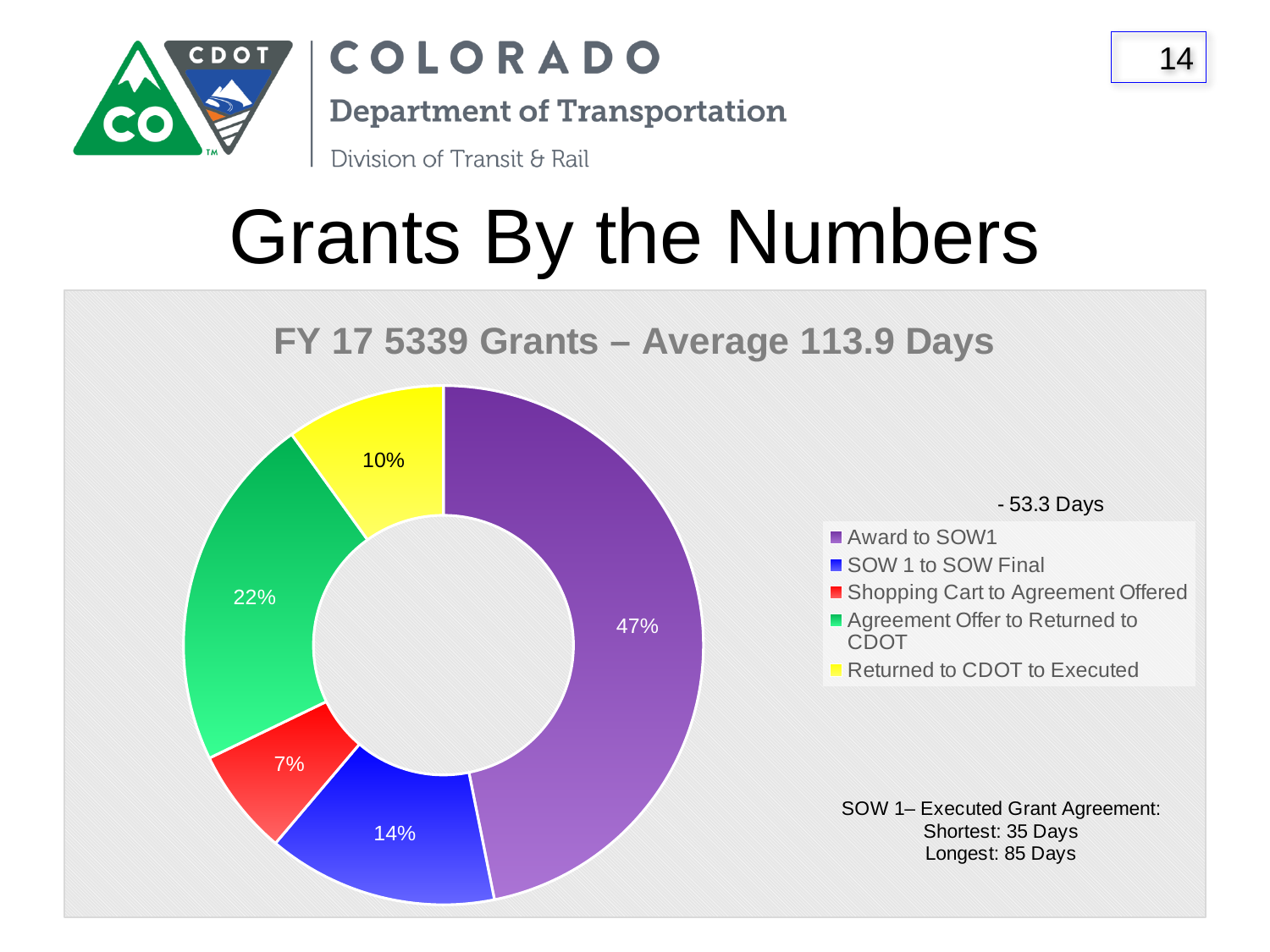
How many categories does the legend list? 5 What type of chart is shown on the slide? Doughnut chart What share of the chart is Shopping Cart to Agreement Offered? 7% What is the difference in percentage points between Award to SOW1 and Agreement Offer to Returned to CDOT? 25 What percentage is shown for Agreement Offer to Returned to CDOT? 22% What is the title of the chart? FY 17 5339 Grants – Average 113.9 Days Which category has the largest share of the chart? Award to SOW1 Which is larger, the SOW 1 to SOW Final slice or the Returned to CDOT to Executed slice? SOW 1 to SOW Final Which category has the smallest share of the chart? Shopping Cart to Agreement Offered What percentage of the doughnut chart is the Award to SOW1 slice? 47% What percentage is shown for Returned to CDOT to Executed? 10% What percentage does the SOW 1 to SOW Final slice represent? 14%